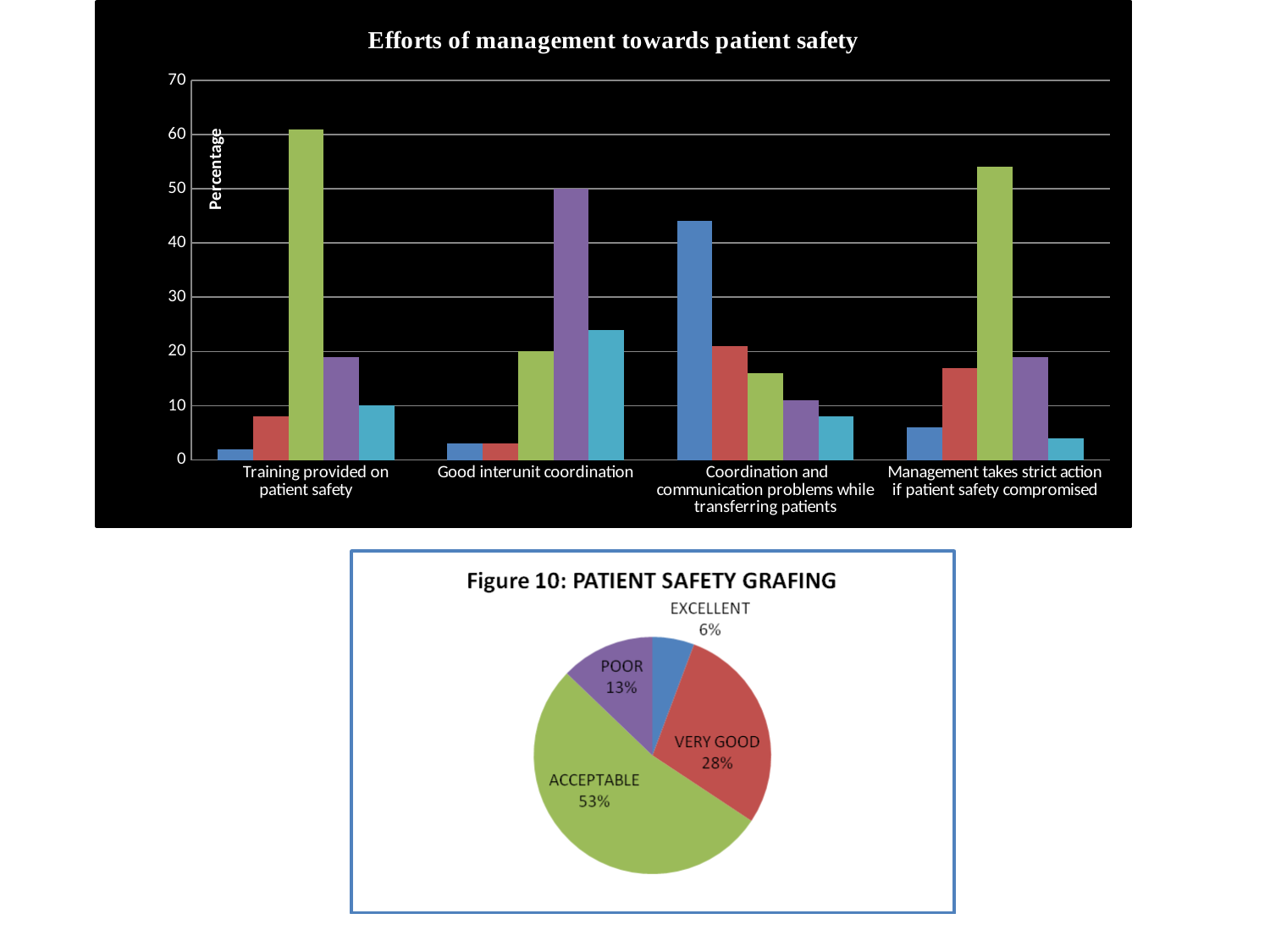
In the pie chart titled 'Figure 10: PATIENT SAFETY GRAFING', what percentage is shown for ACCEPTABLE? 53% In the pie chart titled 'Figure 10: PATIENT SAFETY GRAFING', how many percentage points larger is ACCEPTABLE than VERY GOOD? 25% In the pie chart titled 'Figure 10: PATIENT SAFETY GRAFING', which category has the smallest slice? EXCELLENT What kind of chart is the chart titled 'Efforts of management towards patient safety'? Bar chart In the pie chart titled 'Figure 10: PATIENT SAFETY GRAFING', what percentage is shown for POOR? 13% In the pie chart titled 'Figure 10: PATIENT SAFETY GRAFING', what percentage is shown for VERY GOOD? 28% In the pie chart titled 'Figure 10: PATIENT SAFETY GRAFING', how many slices does the pie have? 4 In the pie chart titled 'Figure 10: PATIENT SAFETY GRAFING', which category has the largest slice? ACCEPTABLE In the chart titled 'Efforts of management towards patient safety', how many categories are shown on the x axis? 4 In the pie chart titled 'Figure 10: PATIENT SAFETY GRAFING', what percentage is shown for EXCELLENT? 6% In the pie chart titled 'Figure 10: PATIENT SAFETY GRAFING', which is larger, VERY GOOD or POOR? VERY GOOD In the chart titled 'Efforts of management towards patient safety', is the tallest bar for 'Training provided on patient safety' greater or less than 50? greater